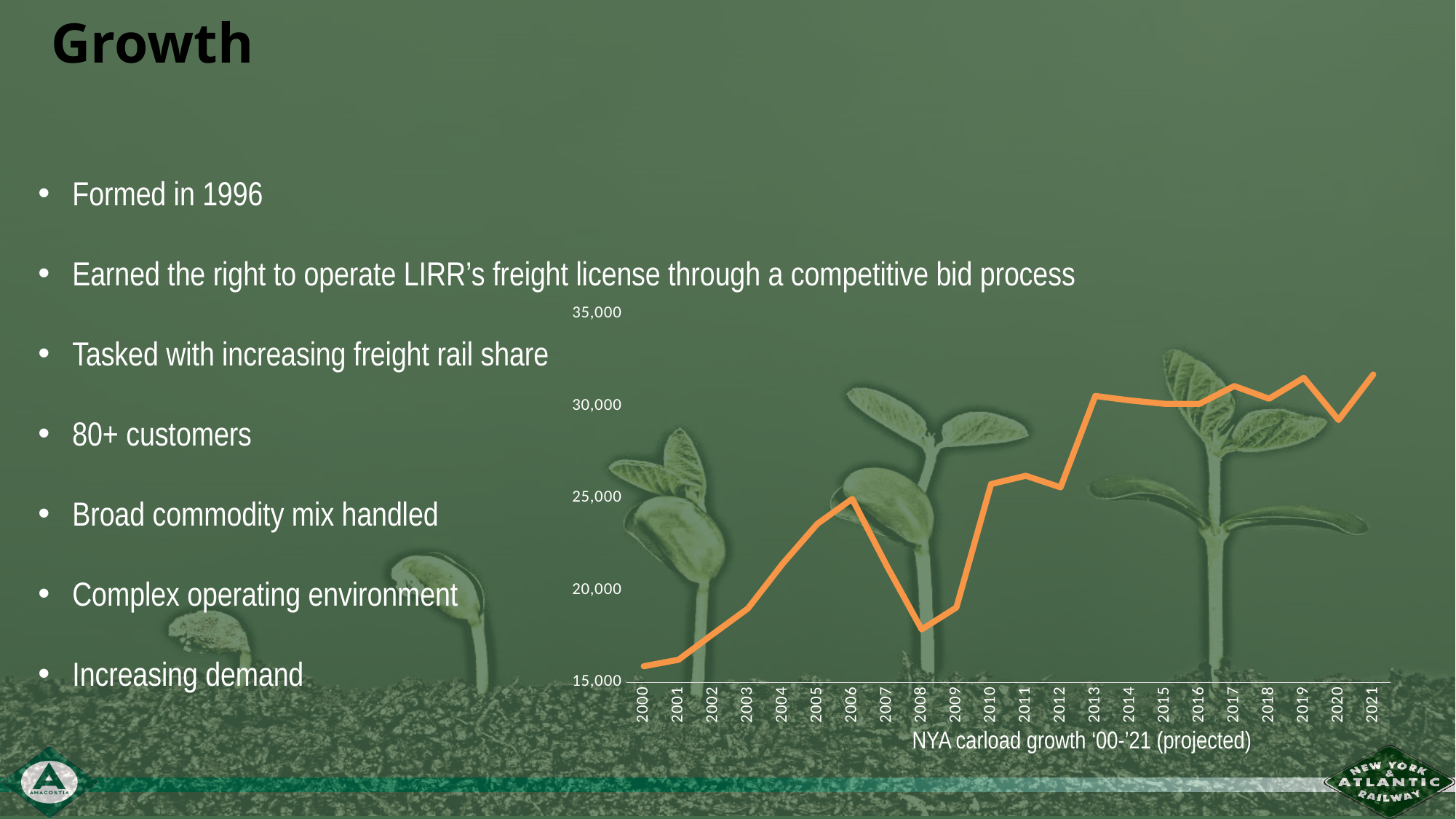
Is the value for 2000 greater or less than 20,000? less Which year has the lowest value on the chart? 2000 Is the value for 2020 greater or less than 30,000? less Overall, do the values rise or fall from 2000 to 2021? rise Is the value for 2021 greater or less than 30,000? greater Which is larger, the value for 2006 or the value for 2008? 2006 How many years are plotted along the x axis of the chart? 22 What is the caption below the chart? NYA carload growth '00-'21 (projected) Which is larger, the value for 2012 or the value for 2013? 2013 What kind of chart is shown on the slide? line chart